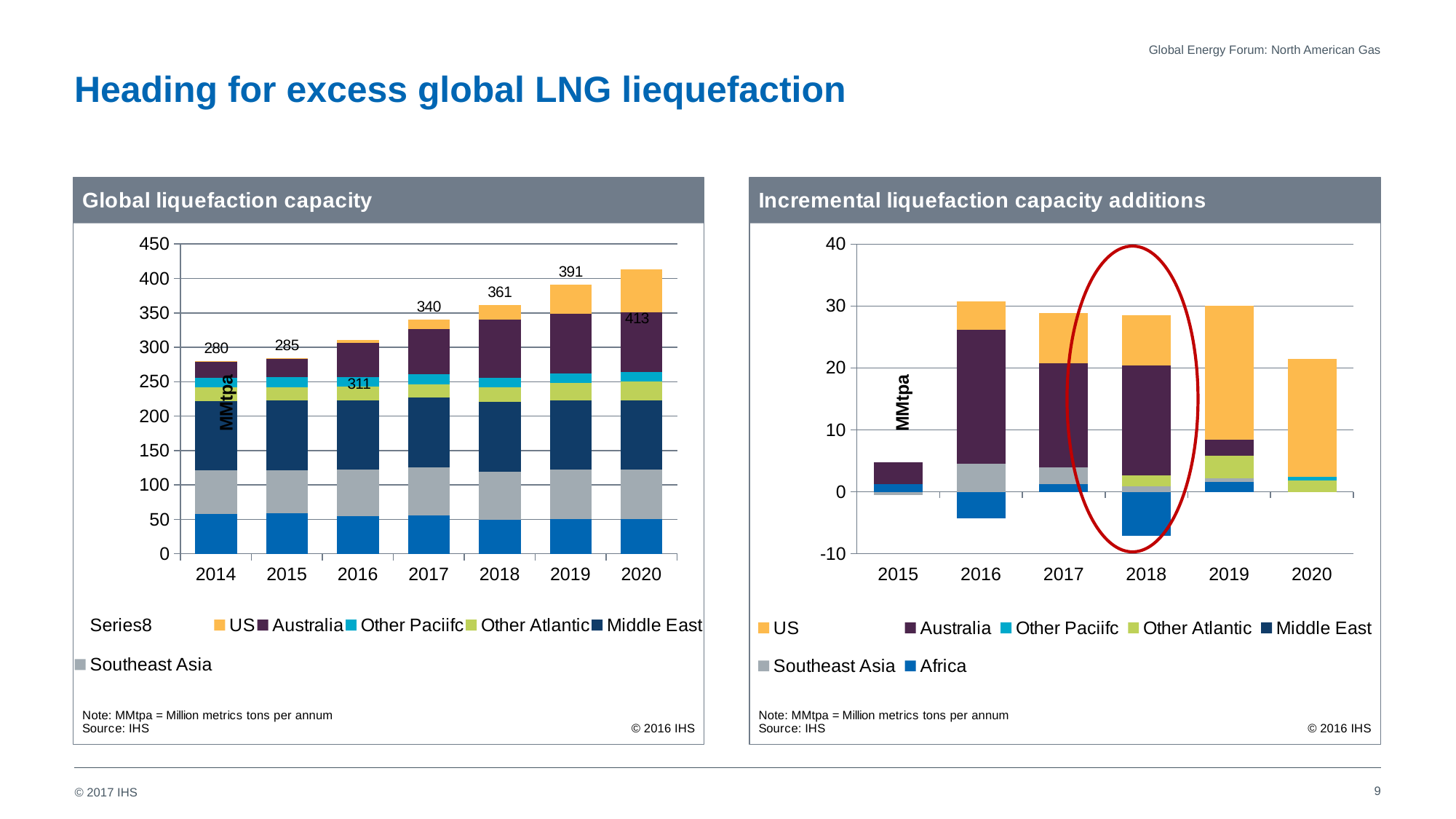
In the 'Global liquefaction capacity' chart, which year has the highest total capacity? 2020 In the 'Incremental liquefaction capacity additions' chart, is the top of the 2019 bar greater or less than 20? greater In the 'Incremental liquefaction capacity additions' chart, which year's bar is circled in red? 2018 In the 'Global liquefaction capacity' chart, what is the total capacity shown for 2017? 340 What kind of chart is the 'Incremental liquefaction capacity additions' chart? bar chart In the 'Global liquefaction capacity' chart, do the total values rise or fall from 2014 to 2020? rise In the 'Incremental liquefaction capacity additions' chart, how many series does the legend list? 7 In the 'Global liquefaction capacity' chart, which year has the lowest total capacity? 2014 In the 'Global liquefaction capacity' chart, what is the difference between the 2020 total and the 2014 total? 133 In the 'Global liquefaction capacity' chart, what is the difference between the 2019 total and the 2018 total? 30 In the 'Global liquefaction capacity' chart, how many years are shown on the x axis? 7 In the 'Global liquefaction capacity' chart, what is the total capacity shown for 2020? 413